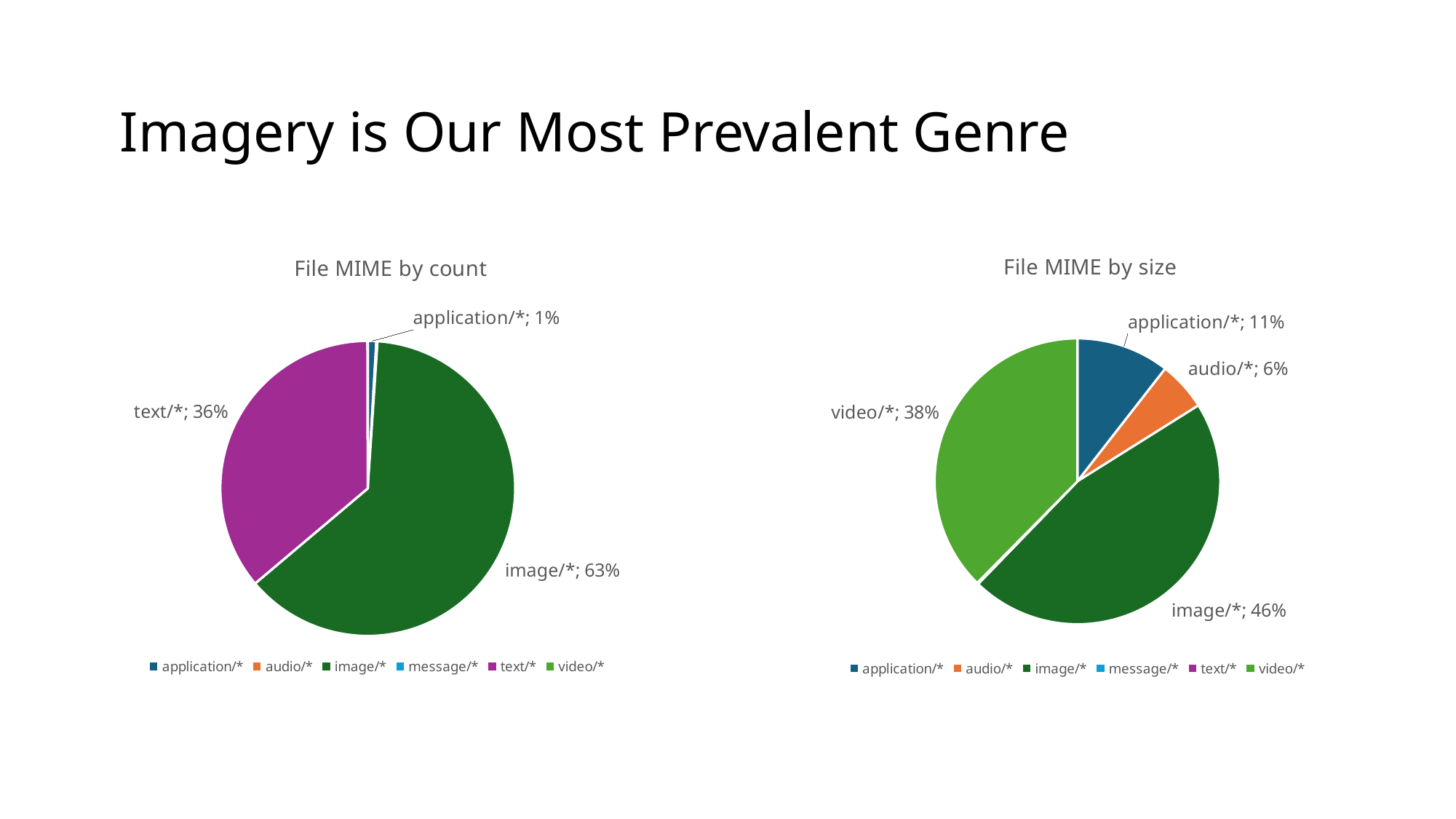
How many entries does the legend of the 'File MIME by size' chart list? 6 In the 'File MIME by count' chart, what is the difference between the image/* and text/* shares? 27% In the 'File MIME by size' chart, which is larger, application/* or audio/*? application/* What type of chart is 'File MIME by count'? pie chart In the 'File MIME by count' chart, what share does image/* have? 63% What is the title of the chart on the left of the slide? File MIME by count In the 'File MIME by size' chart, which labelled category has the smallest slice? audio/* In the 'File MIME by count' chart, what share does text/* have? 36% In the 'File MIME by size' chart, which category has the largest slice? image/* In the 'File MIME by size' chart, what share does video/* have? 38% In the 'File MIME by size' chart, what share does audio/* have? 6% In the 'File MIME by count' chart, what share does application/* have? 1%